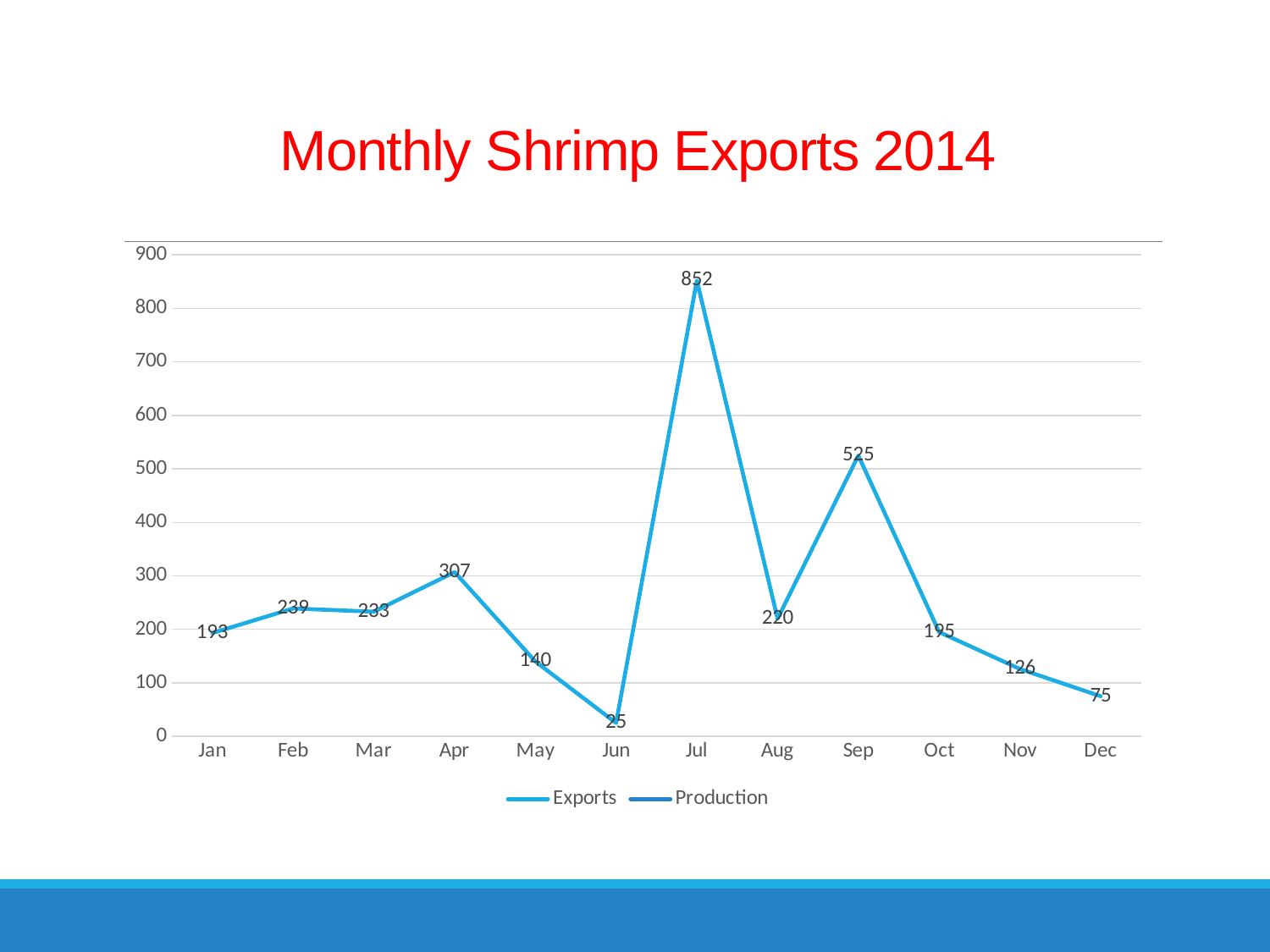
What is the difference between the Exports values for Feb and Mar? 6 What kind of chart is shown on the slide? line chart Which month has the lowest Exports value? Jun Which is larger, the Exports value for Aug or for Oct? Aug What is the Exports value for Nov? 126 What is the Exports value for Apr? 307 Which month has the highest Exports value? Jul Is the Exports value for May greater or less than 200? less How many months are plotted on the x axis? 12 What is the difference between the Exports values for Jul and Sep? 327 What is the Exports value for Jul? 852 How many series does the legend list? 2